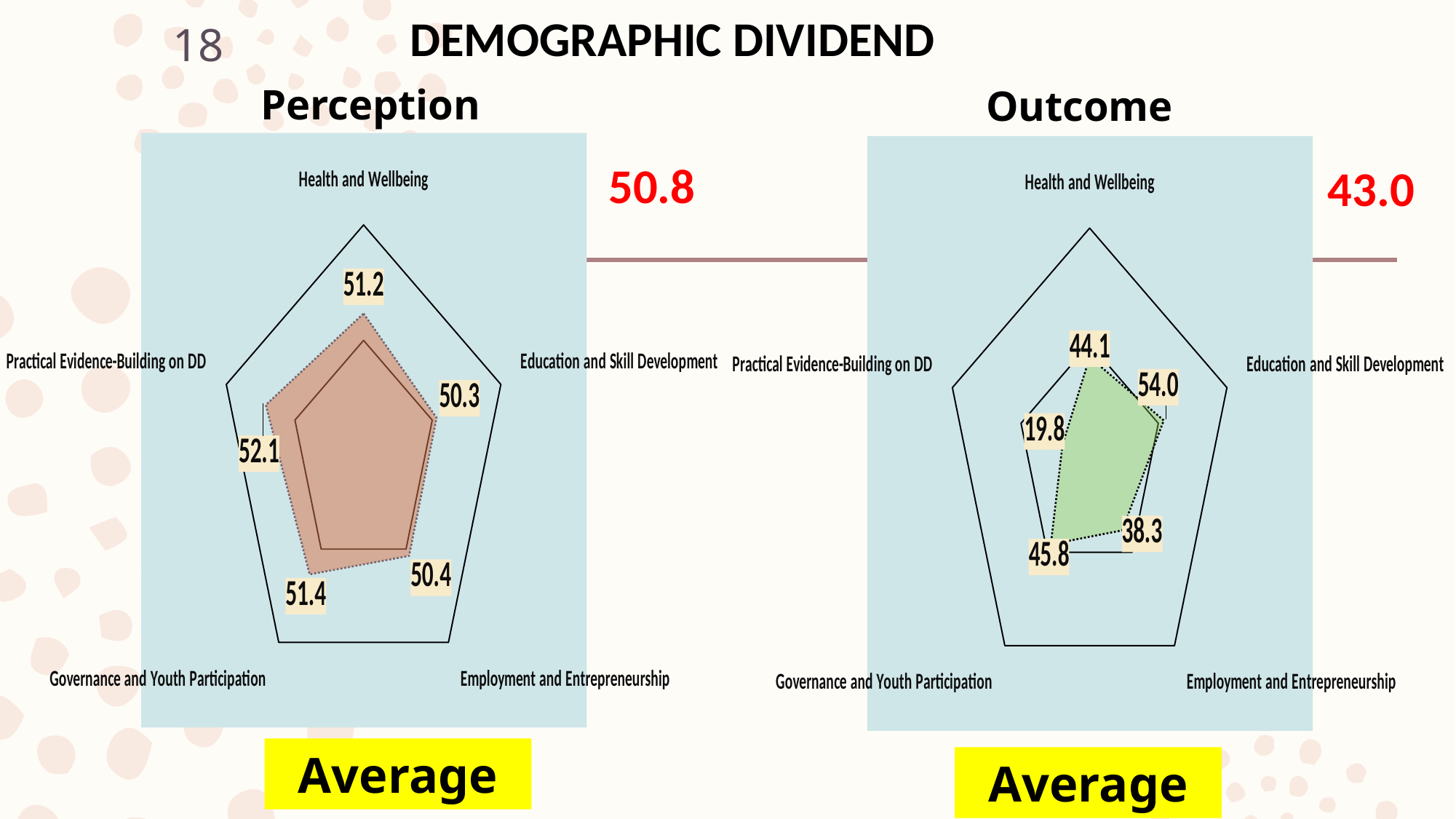
In the Perception chart, what is the value for Practical Evidence-Building on DD? 52.1 In the Outcome chart, which category has the lowest value? Practical Evidence-Building on DD In the Outcome chart, what is the value for Education and Skill Development? 54.0 In the Perception chart, which category has the highest value? Practical Evidence-Building on DD In the Outcome chart, what is the difference between Education and Skill Development and Practical Evidence-Building on DD? 34.2 In the Outcome chart, what is the value for Employment and Entrepreneurship? 38.3 In the Perception chart, what is the difference between Governance and Youth Participation and Education and Skill Development? 1.1 What kind of chart is the Outcome chart? Radar chart In the Perception chart, what is the value for Health and Wellbeing? 51.2 In the Outcome chart, which category has the highest value? Education and Skill Development Which is larger: Governance and Youth Participation in the Outcome chart or Health and Wellbeing in the Outcome chart? Governance and Youth Participation How many categories does the Perception chart have? 5